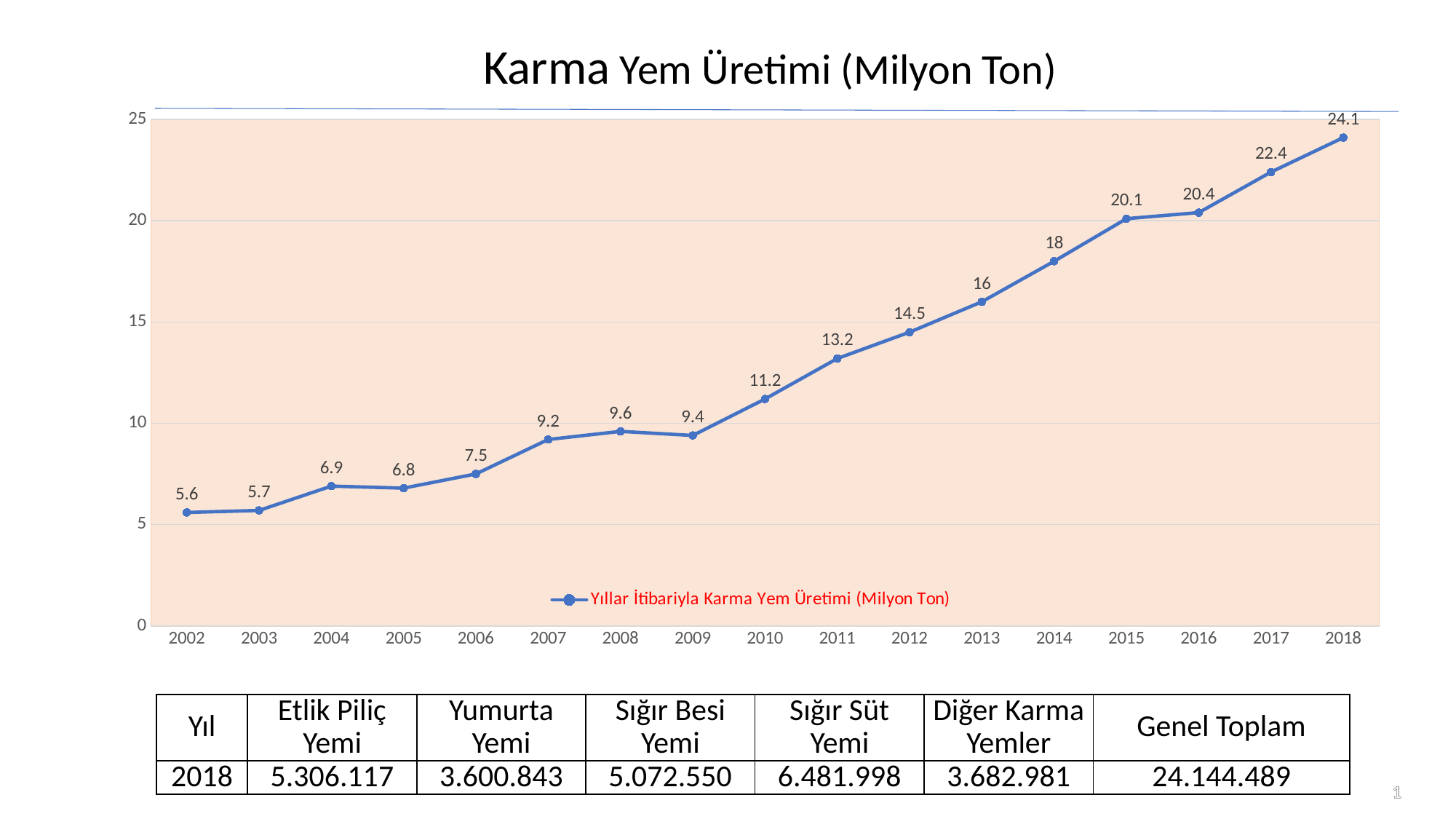
What is the value for 2010? 11.2 Which is larger, the value for 2008 or the value for 2009? 2008 How many years are plotted on the chart? 17 Is the value for 2014 greater or less than 15? greater What kind of chart is shown? line chart How many series does the legend list? 1 Which year has the highest value? 2018 What is the value for 2002? 5.6 Which year has the lowest value? 2002 What is the value for 2018? 24.1 What is the difference between the values for 2018 and 2017? 1.7 What is the title of the chart? Karma Yem Üretimi (Milyon Ton)